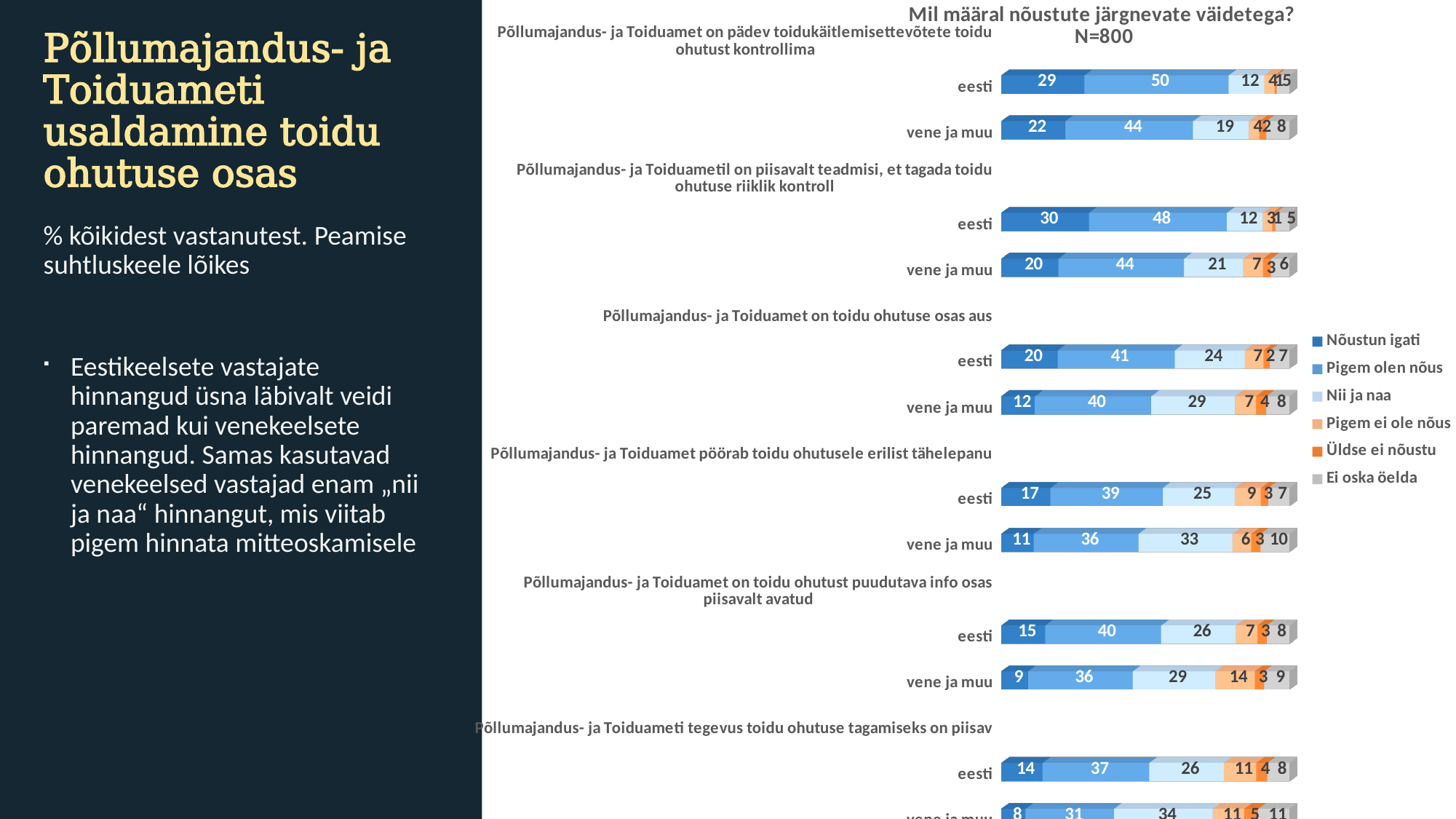
What kind of chart is shown on the slide? Stacked bar chart What is the 'Ei oska öelda' value for vene ja muu respondents on the statement 'Põllumajandus- ja Toiduamet pöörab toidu ohutusele erilist tähelepanu'? 10 What is the 'Nii ja naa' value for vene ja muu respondents on the statement 'Põllumajandus- ja Toiduamet pöörab toidu ohutusele erilist tähelepanu'? 33 What is the difference between the 'Nõustun igati' values of eesti and vene ja muu on the statement 'Põllumajandus- ja Toiduametil on piisavalt teadmisi, et tagada toidu ohutuse riiklik kontroll'? 10 Which statement has the highest 'Nõustun igati' value among eesti respondents? Põllumajandus- ja Toiduametil on piisavalt teadmisi, et tagada toidu ohutuse riiklik kontroll What is the 'Pigem ei ole nõus' value for vene ja muu respondents on the statement 'Põllumajandus- ja Toiduamet on toidu ohutust puudutava info osas piisavalt avatud'? 14 Which group has the higher 'Nõustun igati' value on the statement 'Põllumajandus- ja Toiduamet on toidu ohutuse osas aus', eesti or vene ja muu? eesti What is the 'Pigem olen nõus' value for eesti respondents on the statement 'Põllumajandus- ja Toiduameti tegevus toidu ohutuse tagamiseks on piisav'? 37 What is the 'Pigem olen nõus' value for vene ja muu respondents on the statement 'Põllumajandus- ja Toiduametil on piisavalt teadmisi, et tagada toidu ohutuse riiklik kontroll'? 44 What is the sample size (N) shown in the chart title? N=800 What is the 'Nõustun igati' value for eesti respondents on the statement 'Põllumajandus- ja Toiduamet on pädev toidukäitlemisettevõtete toidu ohutust kontrollima'? 29 How many series does the legend list? 6